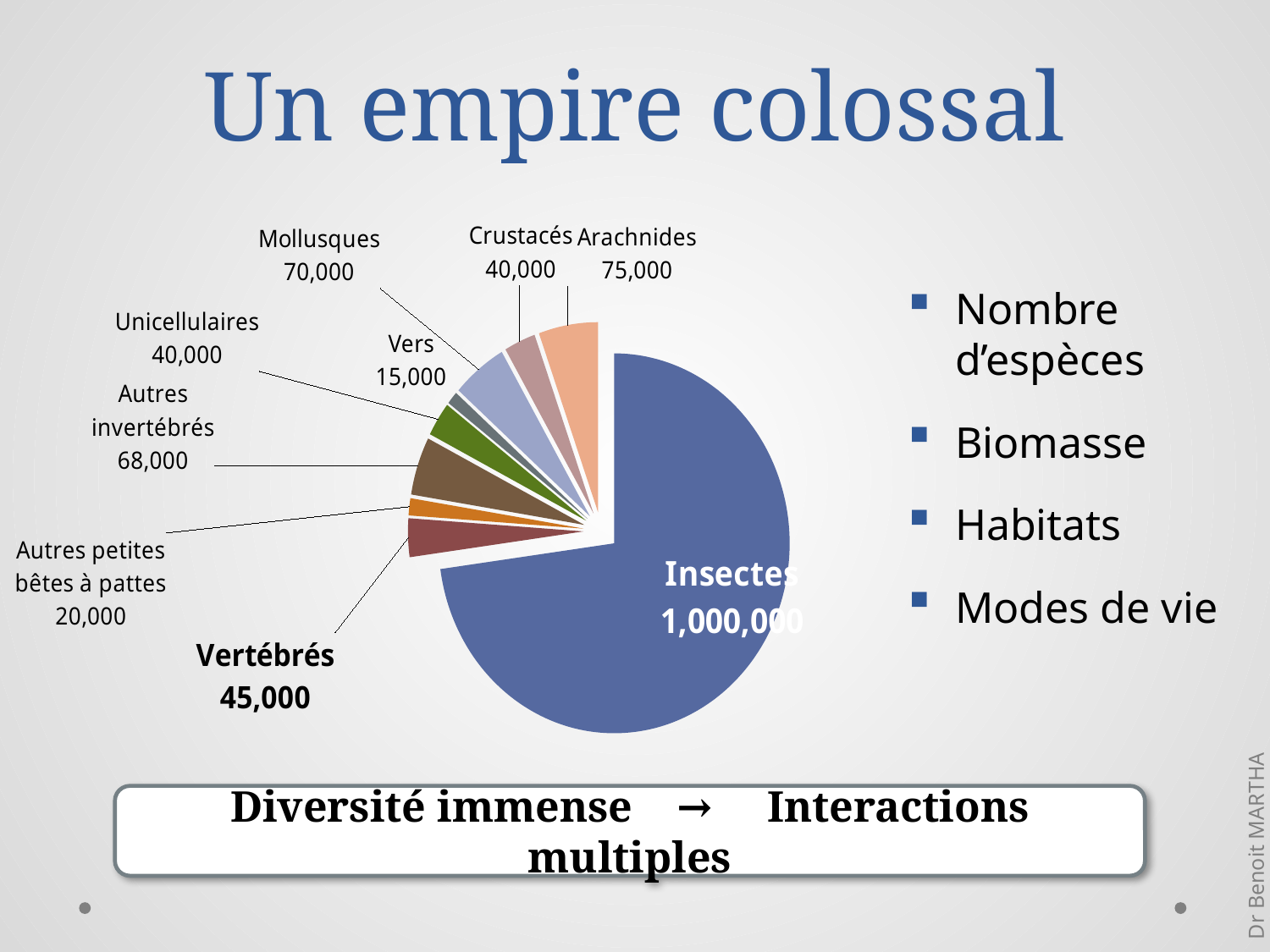
What is the value shown for Insectes? 1,000,000 What is the value shown for Autres invertébrés? 68,000 Which category has the largest slice of the pie? Insectes What is the difference between the values for Arachnides and Mollusques? 5,000 What is the title of the slide containing the pie chart? Un empire colossal Which has a larger value, Mollusques or Arachnides? Arachnides What is the value shown for Arachnides? 75,000 What is the difference between the values for Insectes and Vertébrés? 955,000 What kind of chart is shown on the slide? pie chart Which category has the smallest value in the pie chart? Vers What is the value shown for Vertébrés? 45,000 How many categories are shown in the pie chart? 9